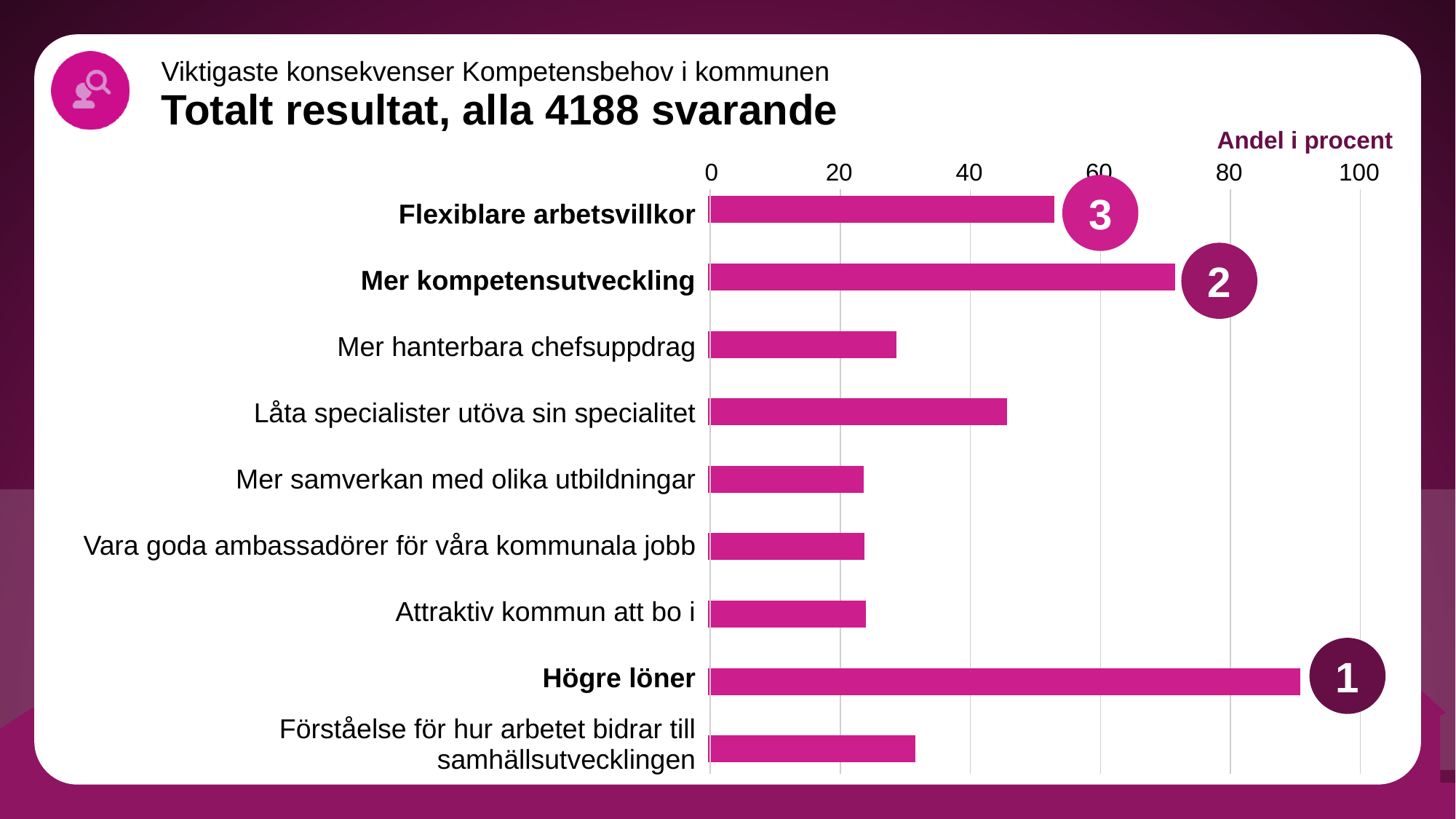
What is the label shown above the horizontal axis of the chart? Andel i procent Is the value for Låta specialister utöva sin specialitet greater or less than 40? greater Which is larger, the value for Förståelse för hur arbetet bidrar till samhällsutvecklingen or the value for Låta specialister utöva sin specialitet? Låta specialister utöva sin specialitet Is the value for Mer kompetensutveckling greater or less than 60? greater Which is larger, the value for Mer kompetensutveckling or the value for Flexiblare arbetsvillkor? Mer kompetensutveckling Is the value for Flexiblare arbetsvillkor greater or less than 60? less Which category is marked with the circled number 1 in the chart? Högre löner How many categories are plotted in the chart? 9 Which category has the highest value in the chart? Högre löner What kind of chart is shown on the slide? bar chart